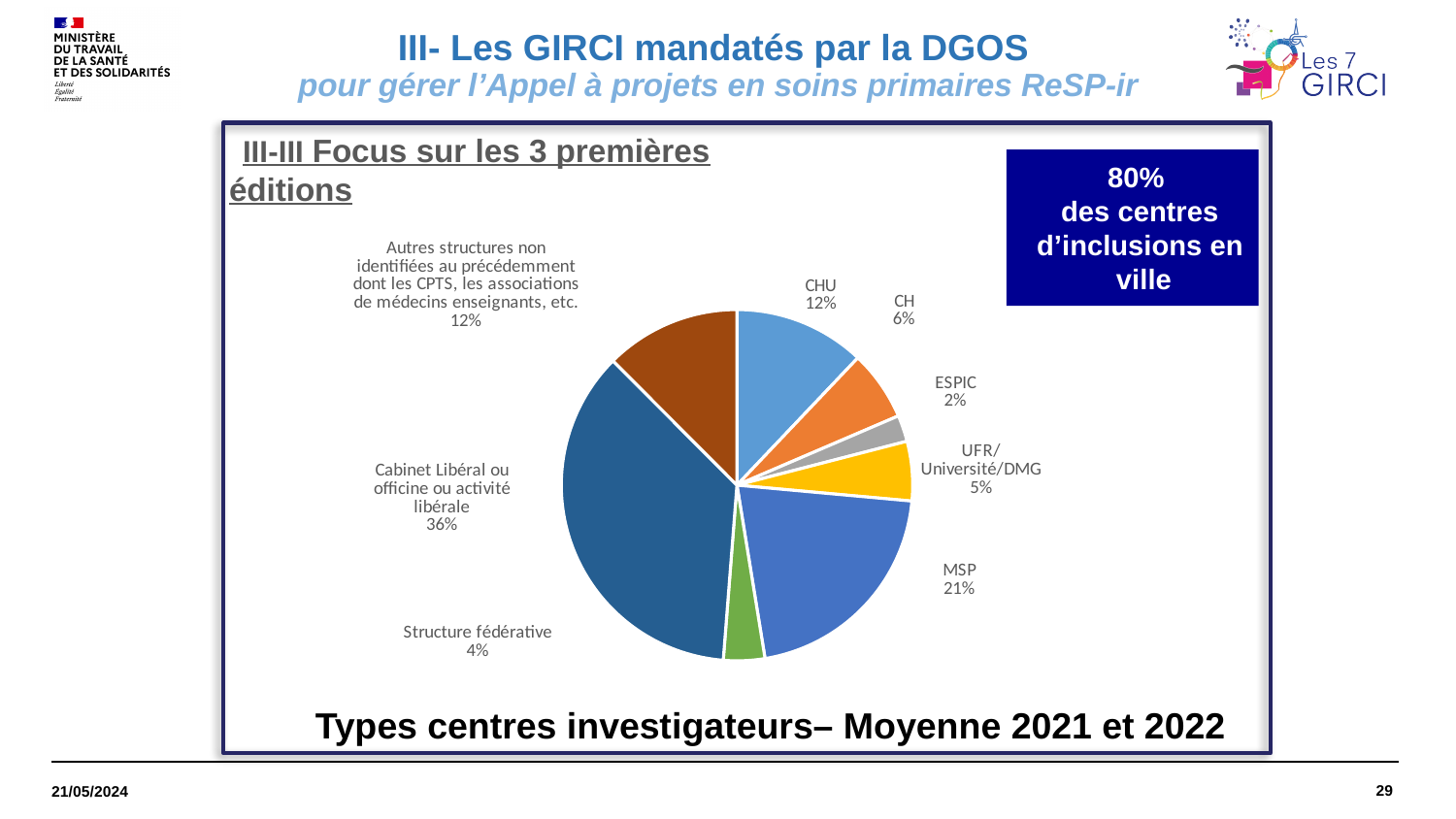
What is the title printed below the pie chart? Types centres investigateurs– Moyenne 2021 et 2022 What share of the pie does MSP represent? 21% Which is larger, the share for CH or the share for UFR/Université/DMG? CH Which category has the smallest slice of the pie? ESPIC What is the value shown for ESPIC? 2% What share of the pie does CHU represent? 12% What is the value shown for UFR/Université/DMG? 5% What is the difference in percentage points between Cabinet Libéral ou officine ou activité libérale and MSP? 15 What kind of chart is shown on the slide? pie chart What is the value shown for Structure fédérative? 4% Which category has the largest slice of the pie? Cabinet Libéral ou officine ou activité libérale How many slices does the pie chart have? 8